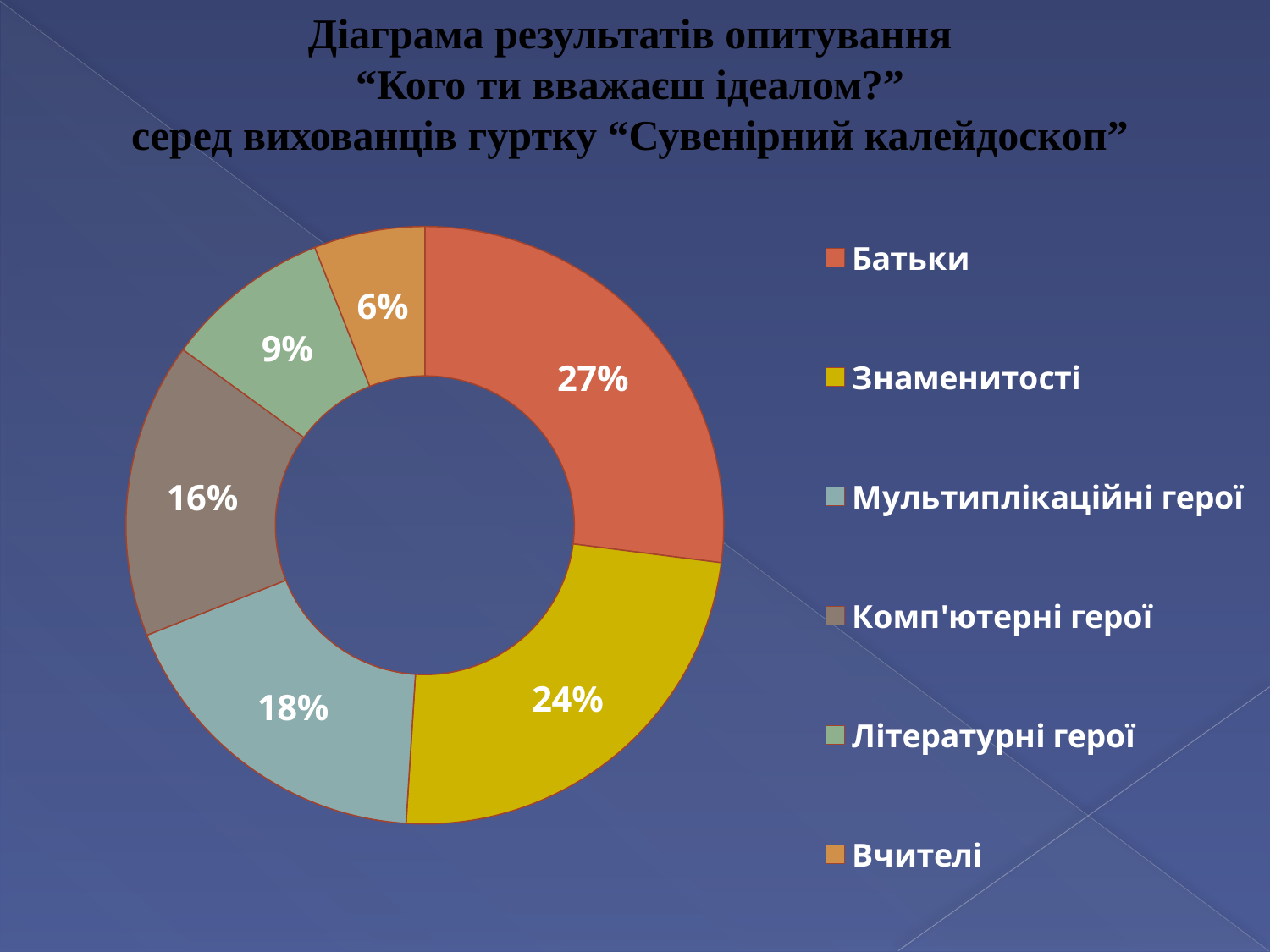
How many categories does the chart show? 6 What share of the chart does Батьки account for? 27% What kind of chart is shown on the slide? Doughnut (pie) chart Which category has the smallest share? Вчителі What percentage is shown for Знаменитості? 24% Which is larger, Мультиплікаційні герої or Комп'ютерні герої? Мультиплікаційні герої What is the value for Мультиплікаційні герої? 18% What is the difference in percentage points between Батьки and Літературні герої? 18 What colour is the Знаменитості segment? Yellow What percentage is shown for Комп'ютерні герої? 16% What is the value for Вчителі? 6% Which category has the largest share? Батьки